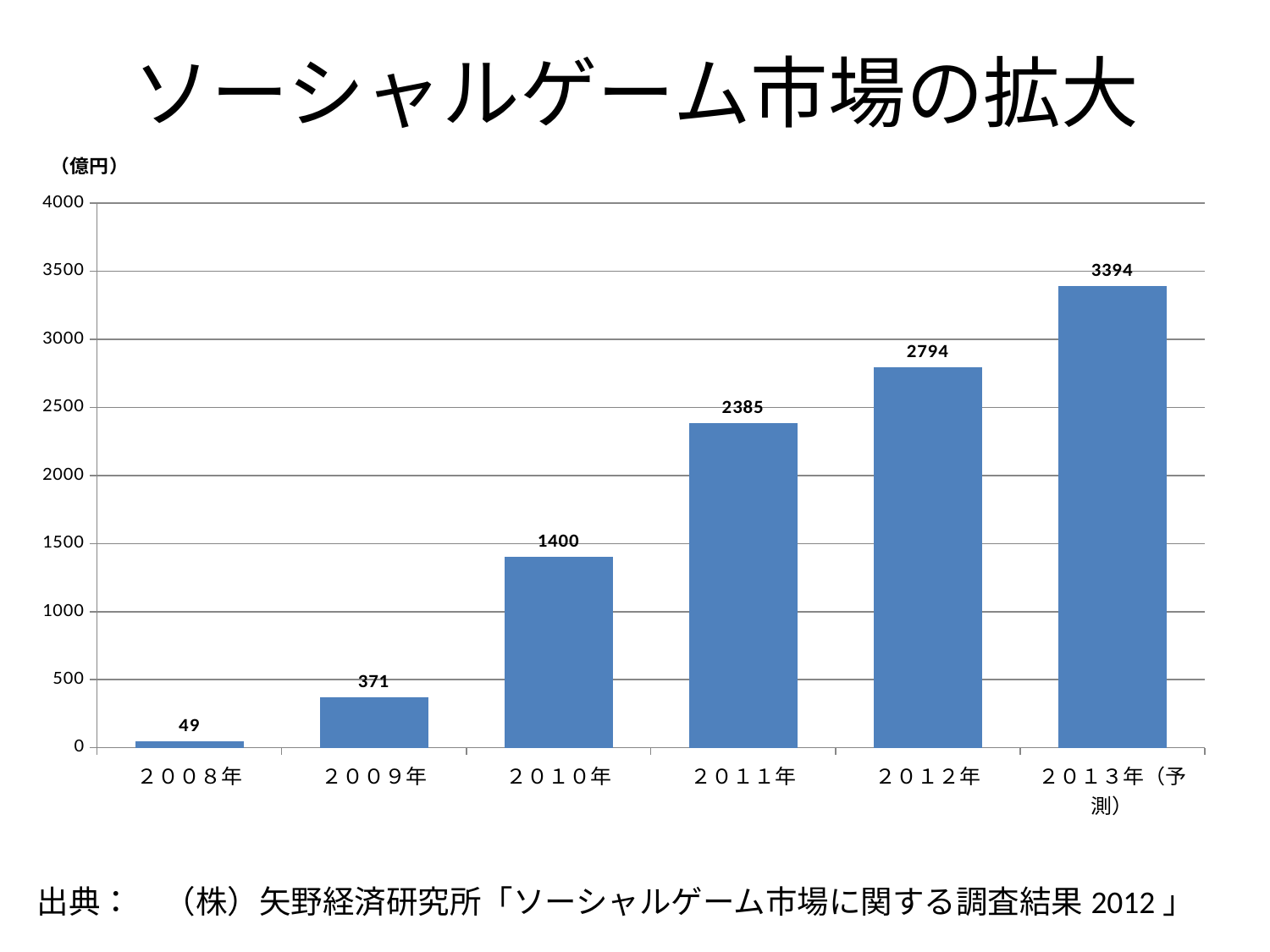
What is the difference between the values for 2013年（予測） and 2012年? 600 What is the difference between the values for 2011年 and 2010年? 985 What is the value for 2012年? 2794 How many years are shown on the x axis? 6 Which year has the lowest value? 2008年 What kind of chart is shown on the slide? bar chart Do the values rise or fall from 2008年 to 2013年（予測）? rise Which year has the highest value? 2013年（予測） Is the value for 2011年 greater or less than 2000? greater What is the value for 2010年? 1400 Which is larger, the value for 2009年 or the value for 2010年? 2010年 What is the value for 2008年? 49